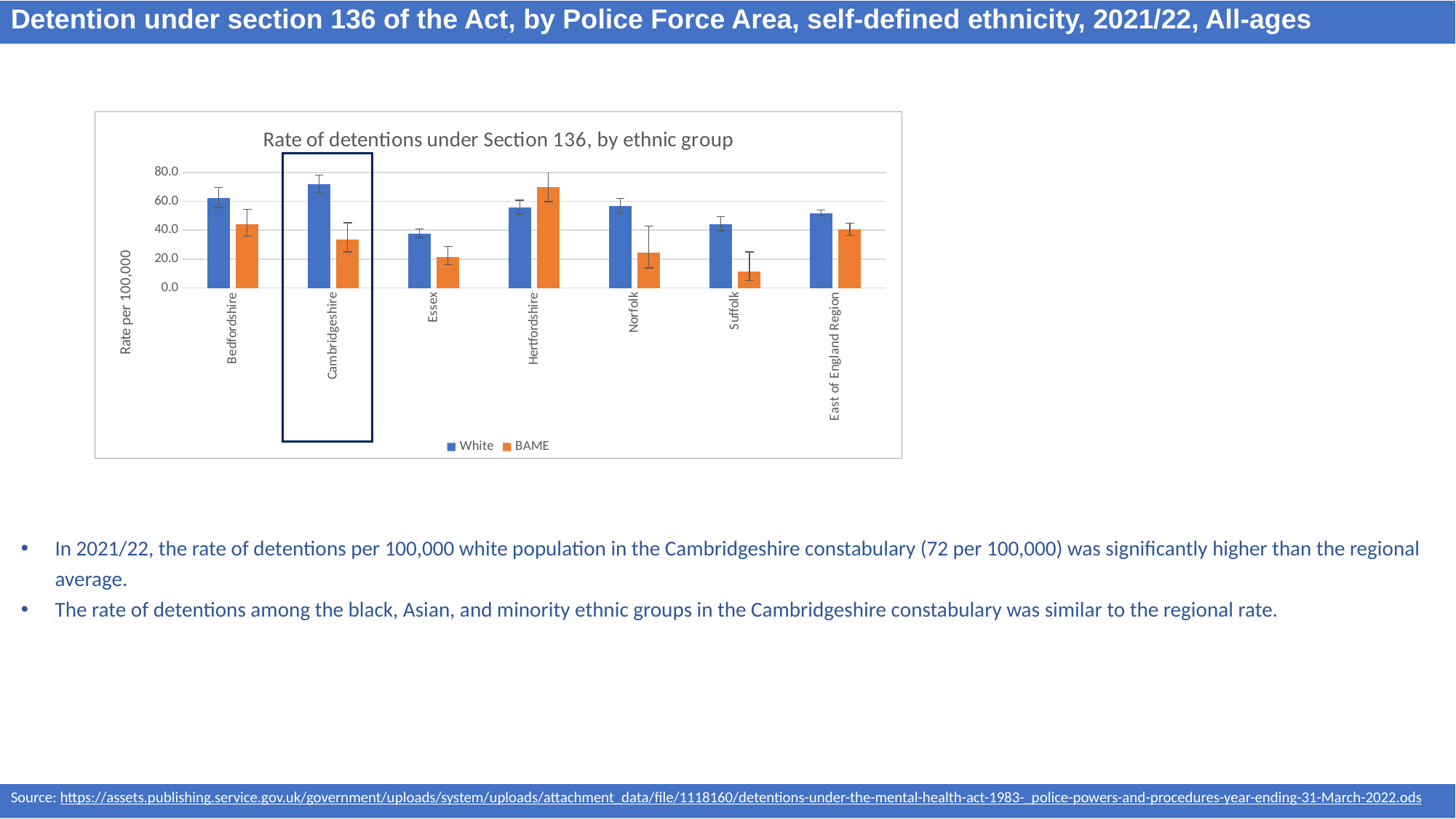
How many police force areas (categories) are shown on the x axis of the chart? 7 How many series does the chart legend list? 2 Which area has the lowest BAME rate of detentions in the chart? Suffolk In Hertfordshire, which group has the higher rate of detentions, White or BAME? BAME What is the label on the vertical axis of the chart? Rate per 100,000 In Norfolk, which group has the higher rate of detentions, White or BAME? White Which area has the highest BAME rate of detentions in the chart? Hertfordshire Is the White rate of detentions for Cambridgeshire greater or less than 60.0? greater Which area has the highest White rate of detentions in the chart? Cambridgeshire What kind of chart is shown on the slide? bar chart Is the BAME rate of detentions for Suffolk greater or less than 20.0? less Which area has the lowest White rate of detentions in the chart? Essex